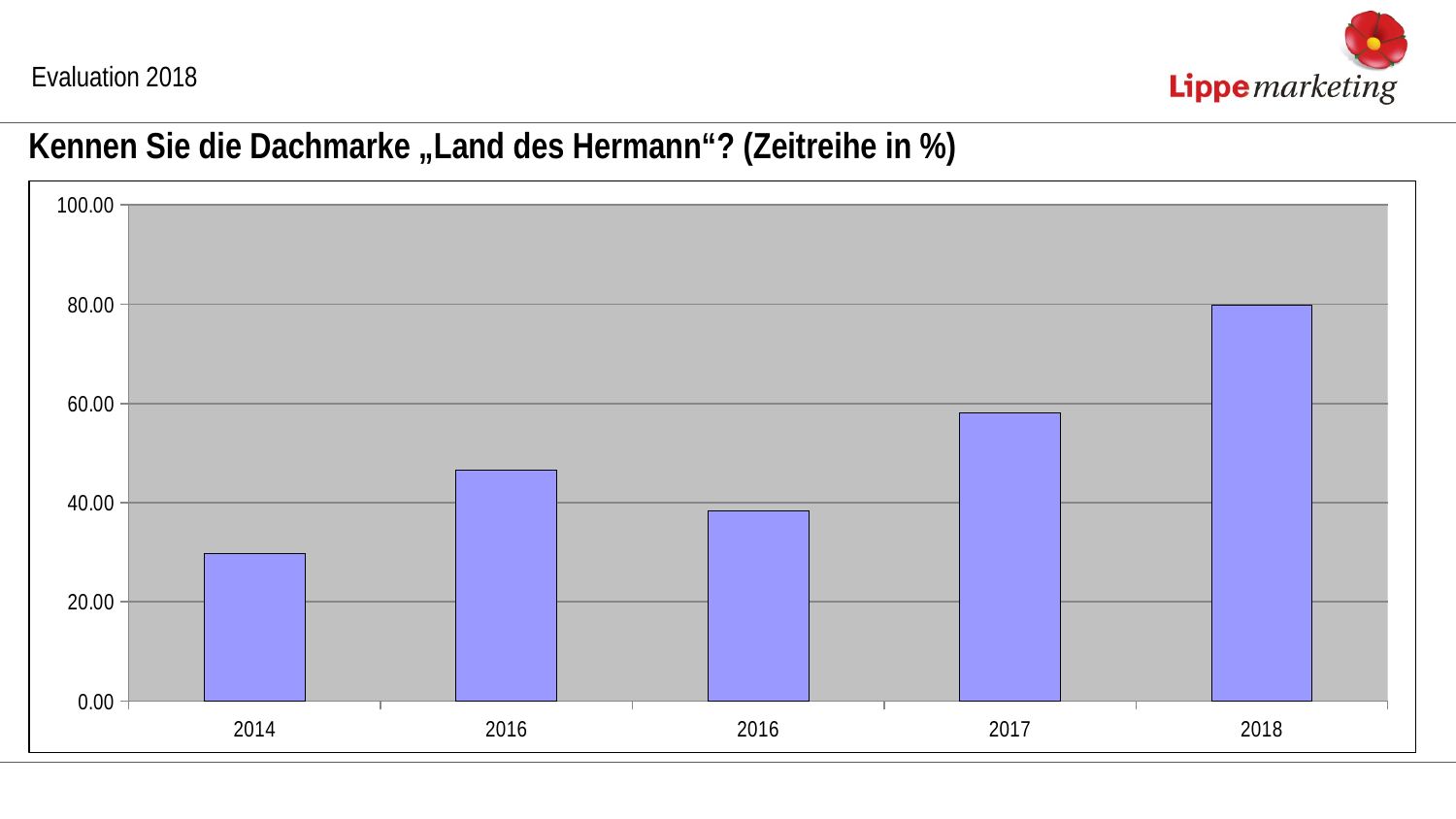
How many bars are plotted in the chart? 5 Which year has the lowest value in the chart? 2014 Is the value for the first bar labelled 2016 greater or less than 40? greater Is the value for 2017 greater or less than 40? greater Does the value rise or fall from 2017 to 2018? rise Which year has the highest value in the chart? 2018 Is the value for 2018 greater or less than 60? greater What kind of chart is shown on the slide? bar chart What is the title of the chart? Kennen Sie die Dachmarke „Land des Hermann“? (Zeitreihe in %) Which is larger, the value for 2017 or the value for 2014? 2017